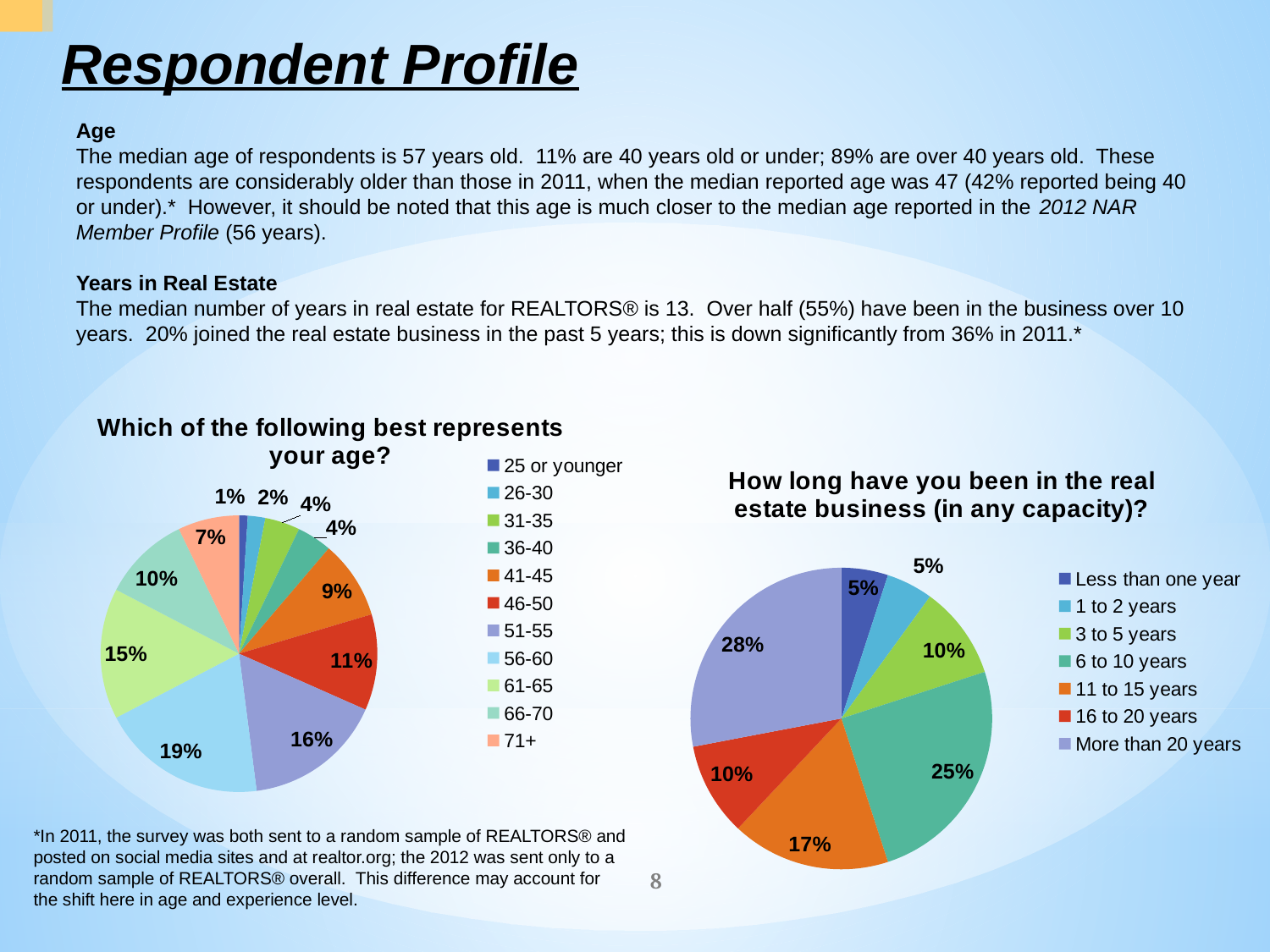
In the 'Which of the following best represents your age?' chart, what is the difference between the shares for 51-55 and 41-45? 7% In the 'How long have you been in the real estate business (in any capacity)?' chart, which is larger: the share for 11 to 15 years or the share for 16 to 20 years? 11 to 15 years In the 'Which of the following best represents your age?' chart, which age group has the largest share? 56-60 In the 'How long have you been in the real estate business (in any capacity)?' chart, which category has the largest share? More than 20 years In the 'Which of the following best represents your age?' chart, what share of respondents are aged 46-50? 11% In the 'Which of the following best represents your age?' chart, what share of respondents are aged 56-60? 19% In the 'How long have you been in the real estate business (in any capacity)?' chart, what share of respondents have been in the business 6 to 10 years? 25% What type of chart is used for 'How long have you been in the real estate business (in any capacity)?' Pie chart In the 'Which of the following best represents your age?' chart, which age group has the smallest share? 25 or younger In the 'How long have you been in the real estate business (in any capacity)?' chart, what share of respondents have been in the business more than 20 years? 28% In the 'Which of the following best represents your age?' chart, how many age categories does the legend list? 11 In the 'How long have you been in the real estate business (in any capacity)?' chart, how many categories does the legend list? 7